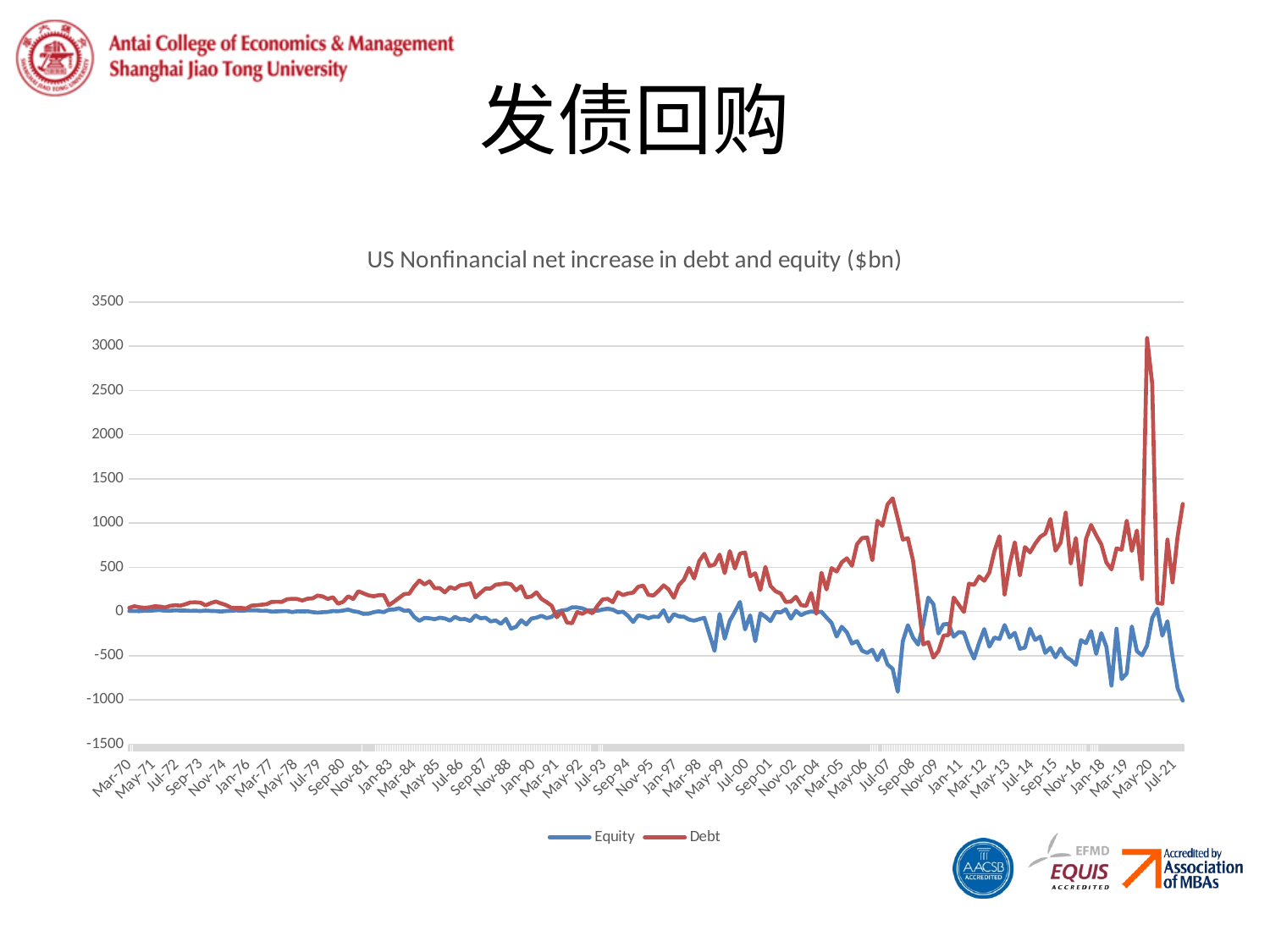
How many series does the legend list? 2 At Jul-21, which series has the higher value, Debt or Equity? Debt Which series is drawn in red? Debt Is the value of the Debt series at Mar-70 greater or less than 500? less Is the peak value of the Debt series (around May-20) greater or less than 2500? greater What kind of chart is shown on the slide? line chart What is the title of the chart? US Nonfinancial net increase in debt and equity ($bn) Is the highest value of the Debt series around Jul-07 greater or less than 1000? greater Over the whole period from Mar-70 to Jul-21, does the Debt series generally rise or fall? rise Over the whole period from Mar-70 to Jul-21, does the Equity series generally rise or fall? fall